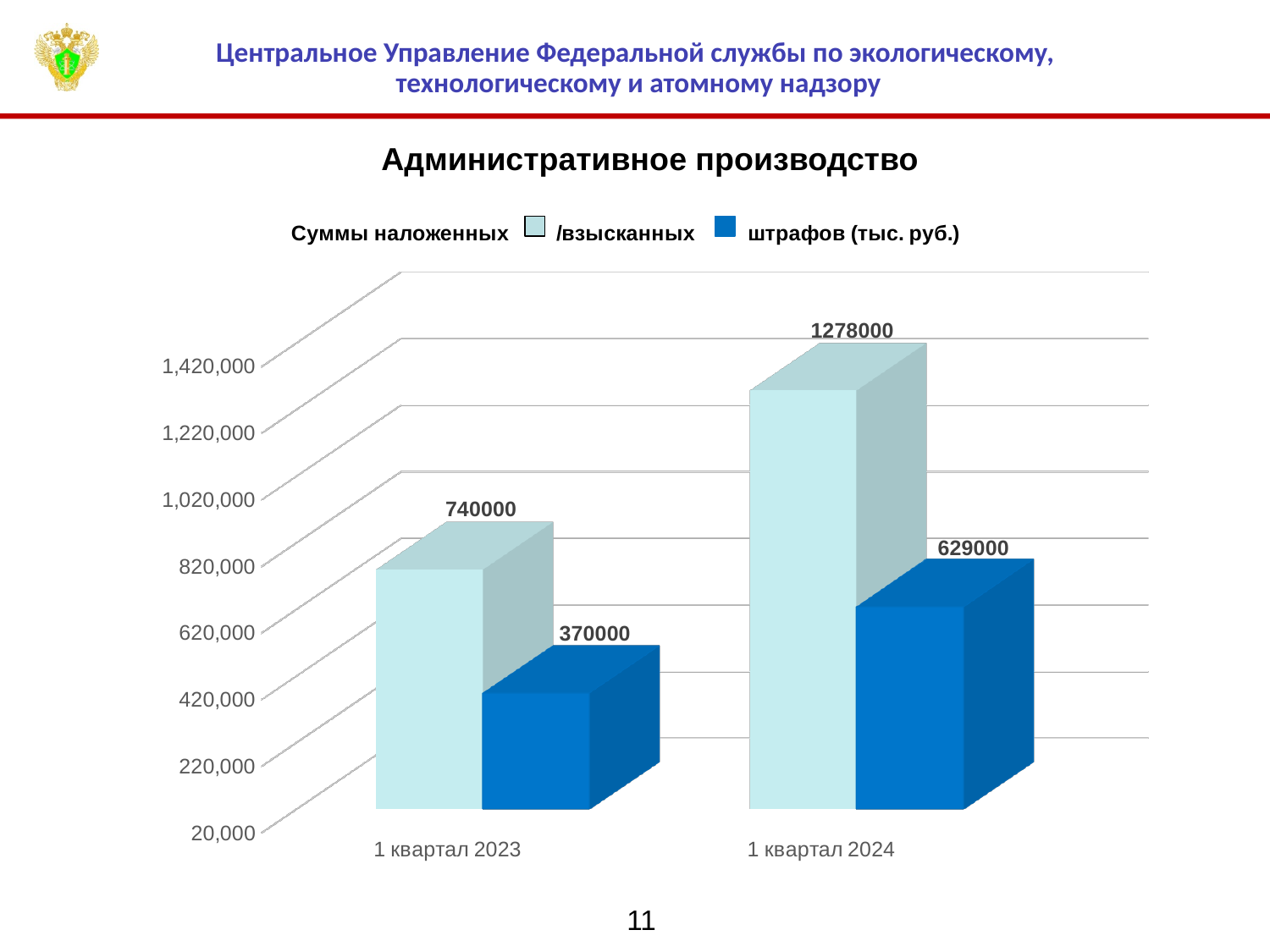
What is the value of the imposed fines (наложенных) for 1 квартал 2024? 1278000 What is the value of the imposed fines (наложенных) for 1 квартал 2023? 740000 Which category has the lowest value for collected fines (взысканных)? 1 квартал 2023 What is the difference between imposed and collected fines in 1 квартал 2023? 370000 Which is larger: collected fines in 1 квартал 2024 or imposed fines in 1 квартал 2023? Imposed fines in 1 квартал 2023 What is the difference between imposed fines in 1 квартал 2024 and 1 квартал 2023? 538000 What kind of chart is shown on the slide? Bar chart What is the value of the collected fines (взысканных) for 1 квартал 2024? 629000 How many categories are shown on the x axis? 2 How many series does the legend list? 2 Which category has the highest value for imposed fines (наложенных)? 1 квартал 2024 What is the value of the collected fines (взысканных) for 1 квартал 2023? 370000